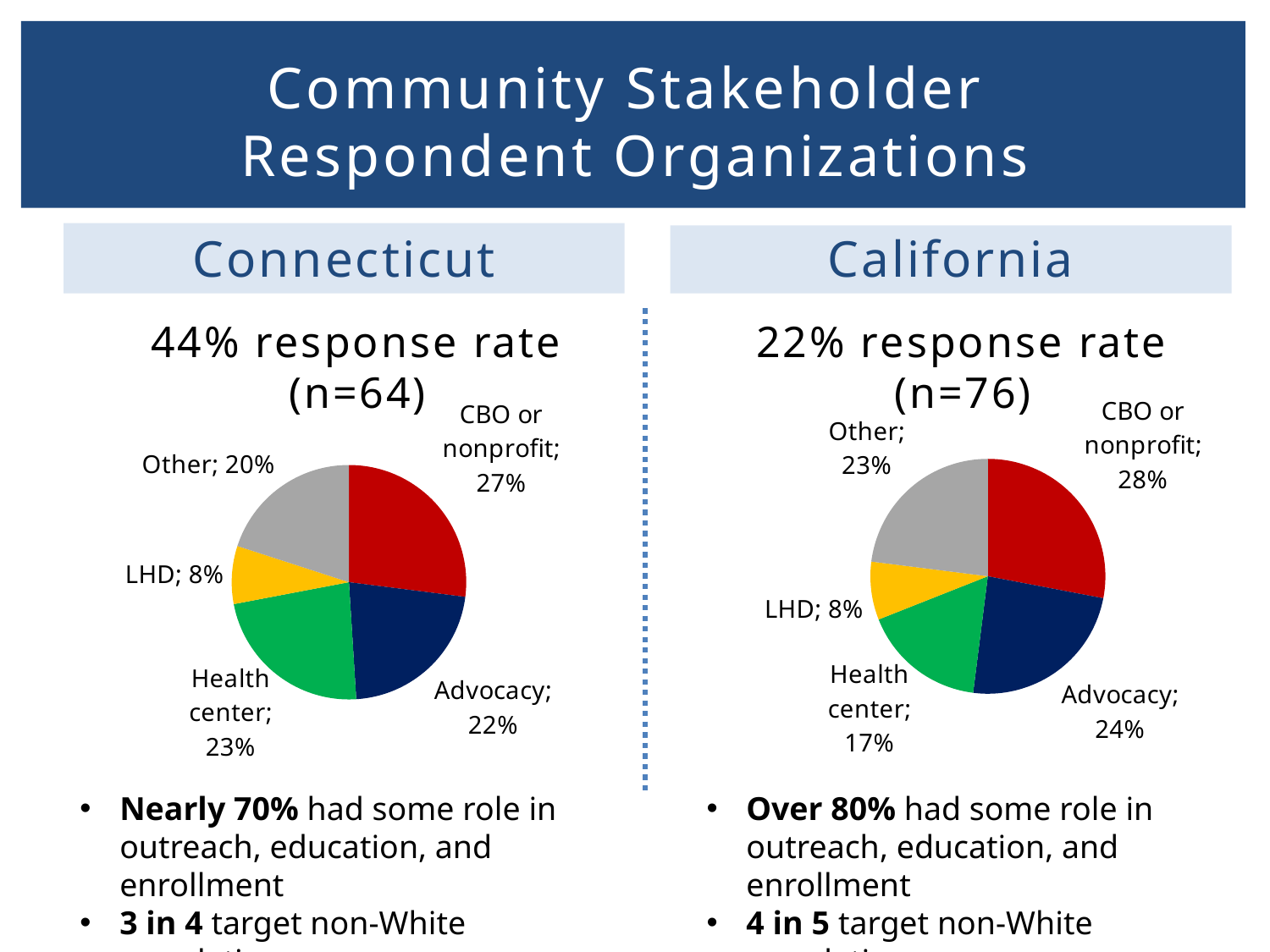
In the California pie chart, what share is Health center? 17% In the Connecticut pie chart, what is the difference between the CBO or nonprofit share and the Other share? 7% In the Connecticut pie chart, what colour is the Advocacy slice? Dark blue In the California pie chart, what is the difference between the Advocacy share and the Health center share? 7% What type of chart is used for Connecticut? Pie chart In the Connecticut pie chart, which category has the smallest share? LHD In the Connecticut pie chart, which is larger, Health center or Advocacy? Health center In the Connecticut pie chart, what share is CBO or nonprofit? 27% In the California pie chart, which category has the smallest share? LHD In the Connecticut pie chart, which category has the largest share? CBO or nonprofit In the California pie chart, what share is Other? 23% How many slices does the California pie chart have? 5